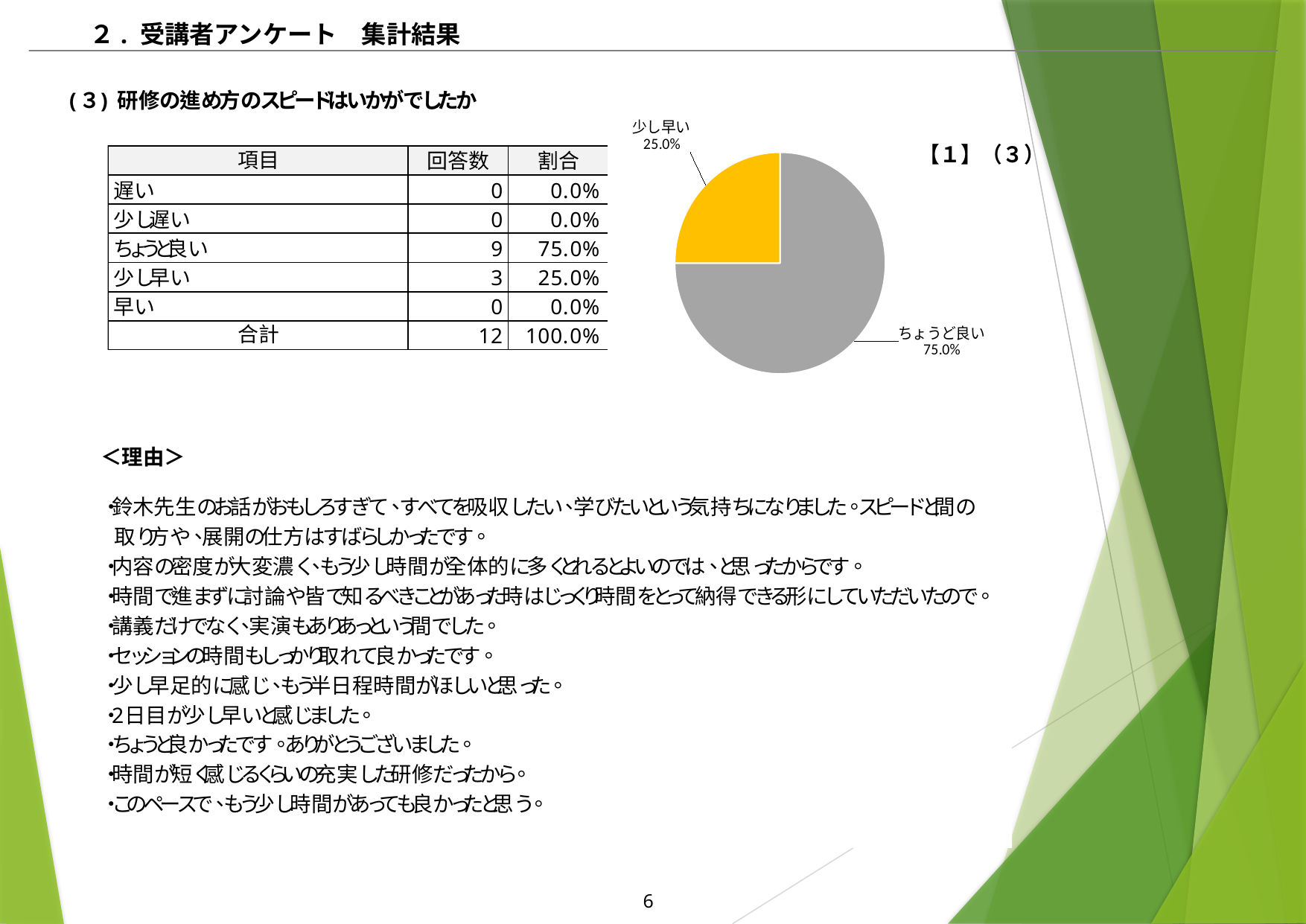
What colour is the ちょうど良い slice in the pie chart? gray Which slice of the pie chart is the largest? ちょうど良い What share of the pie chart does 少し早い take? 25.0% What share of the pie chart does ちょうど良い take? 75.0% How many slices are labelled in the pie chart? 2 Which is larger in the pie chart, ちょうど良い or 少し早い? ちょうど良い What kind of chart is shown on the slide? pie chart What is the total of the two labelled slices in the pie chart? 100.0% What colour is the 少し早い slice in the pie chart? yellow Is the share for ちょうど良い greater or less than 50%? greater Which slice of the pie chart is the smallest? 少し早い What is the difference in percentage points between the ちょうど良い slice and the 少し早い slice? 50.0%